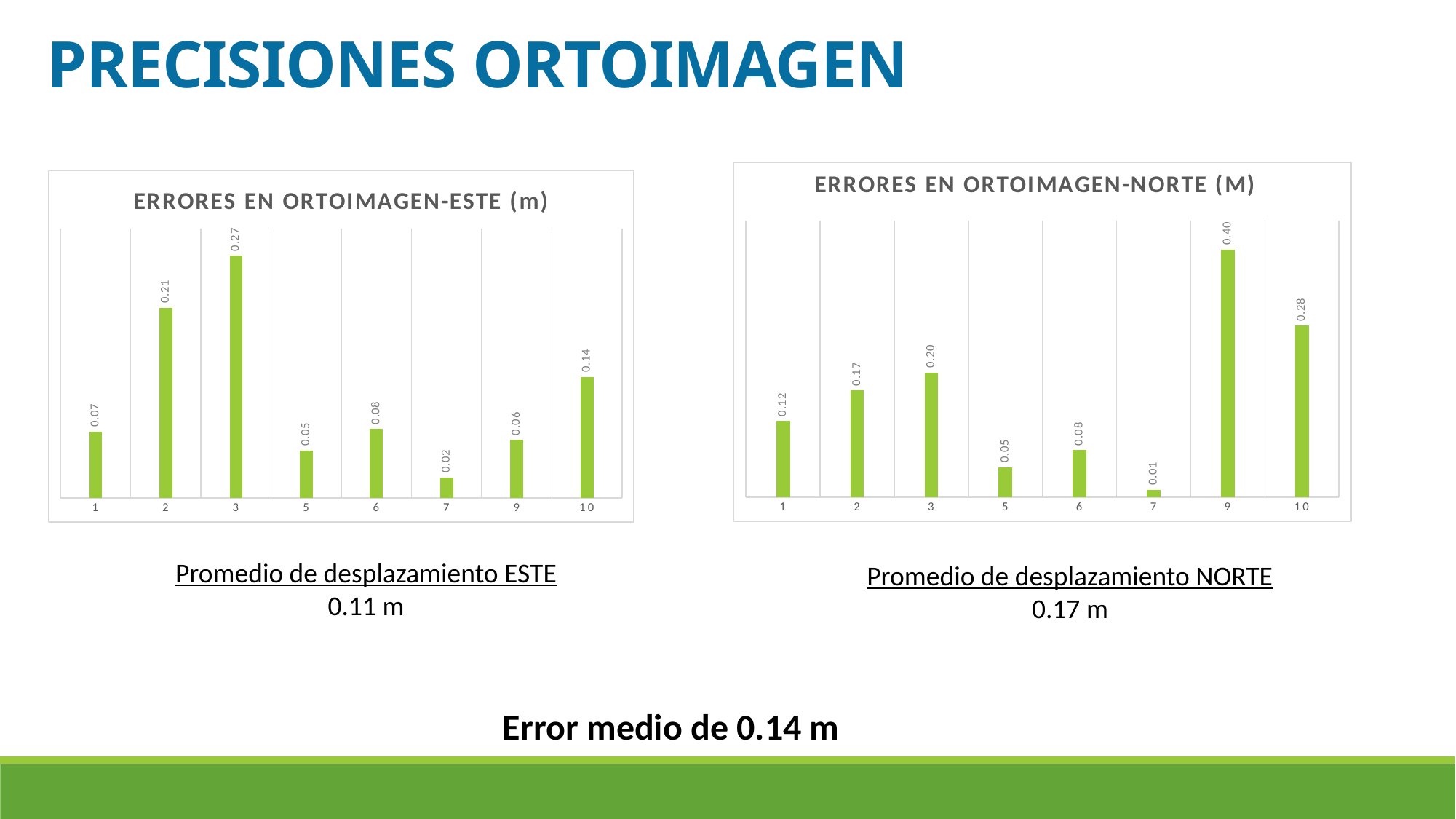
In the chart titled 'ERRORES EN ORTOIMAGEN-ESTE (m)', which category has the highest value? 3 In the chart titled 'ERRORES EN ORTOIMAGEN-NORTE (M)', what is the value for category 1? 0.12 In the chart titled 'ERRORES EN ORTOIMAGEN-ESTE (m)', what is the value for category 10? 0.14 In the chart titled 'ERRORES EN ORTOIMAGEN-NORTE (M)', what is the value for category 9? 0.40 What kind of chart is 'ERRORES EN ORTOIMAGEN-NORTE (M)'? Bar chart In the chart titled 'ERRORES EN ORTOIMAGEN-NORTE (M)', which category has the lowest value? 7 In the chart titled 'ERRORES EN ORTOIMAGEN-NORTE (M)', what is the difference between the values for category 9 and category 10? 0.12 In the chart titled 'ERRORES EN ORTOIMAGEN-ESTE (m)', which category has the lowest value? 7 In the chart titled 'ERRORES EN ORTOIMAGEN-NORTE (M)', which is larger, the value for category 2 or category 3? 3 In the chart titled 'ERRORES EN ORTOIMAGEN-ESTE (m)', what is the difference between the values for category 3 and category 2? 0.06 In the chart titled 'ERRORES EN ORTOIMAGEN-ESTE (m)', what is the value for category 3? 0.27 How many categories are shown in the chart titled 'ERRORES EN ORTOIMAGEN-ESTE (m)'? 8